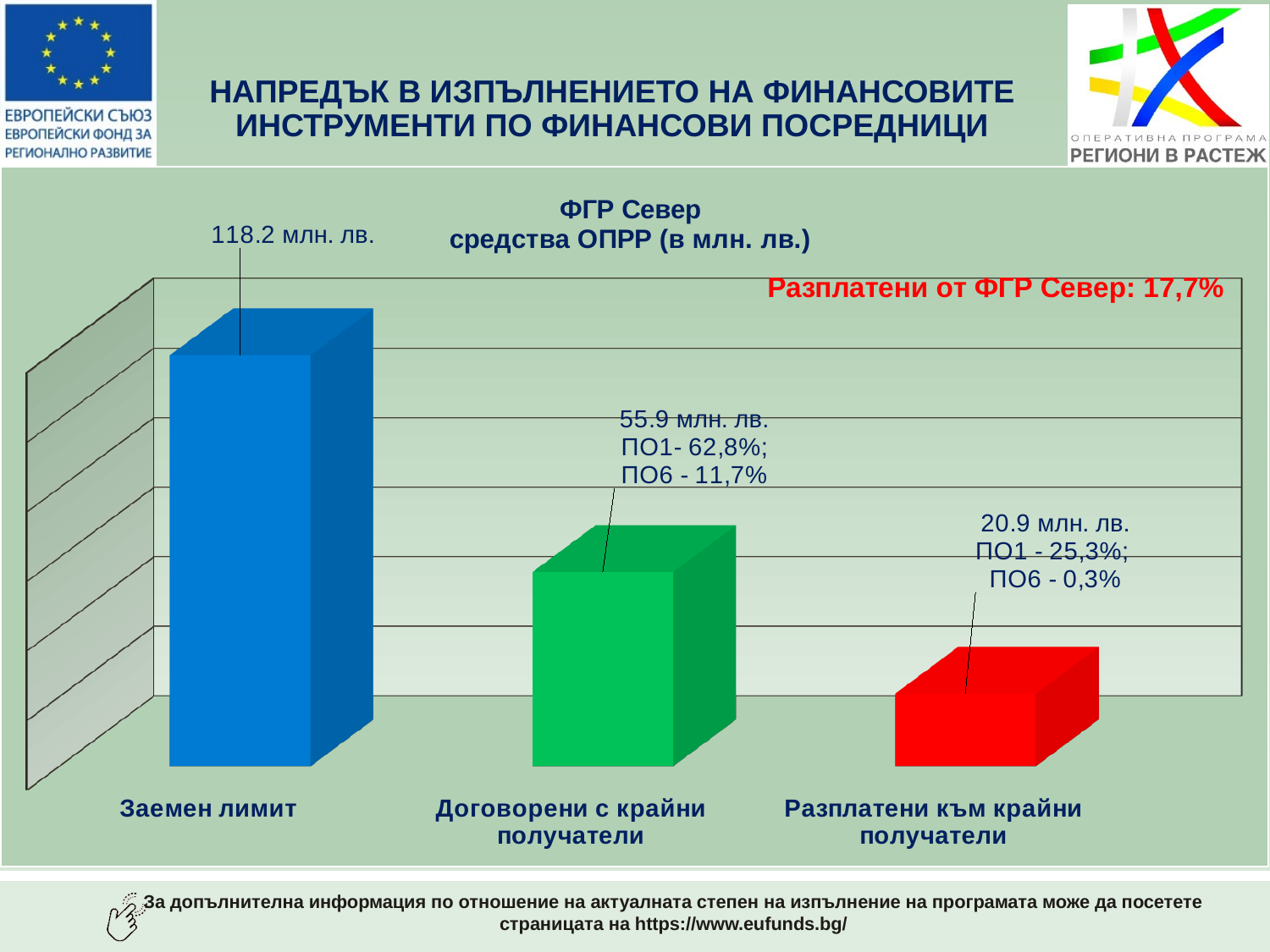
What kind of chart is shown on the slide? Bar chart What is the value for Заемен лимит? 118.2 млн. лв. What is the difference between Договорени с крайни получатели and Разплатени към крайни получатели? 35.0 млн. лв. What is the difference between Заемен лимит and Договорени с крайни получатели? 62.3 млн. лв. Which category has the highest value? Заемен лимит Which is larger, Договорени с крайни получатели or Разплатени към крайни получатели? Договорени с крайни получатели Do the values rise or fall from left to right across the categories? Fall What is the title of the chart? ФГР Север средства ОПРР (в млн. лв.) What is the value for Разплатени към крайни получатели? 20.9 млн. лв. Which category has the lowest value? Разплатени към крайни получатели What is the value for Договорени с крайни получатели? 55.9 млн. лв. How many categories are shown in the chart? 3